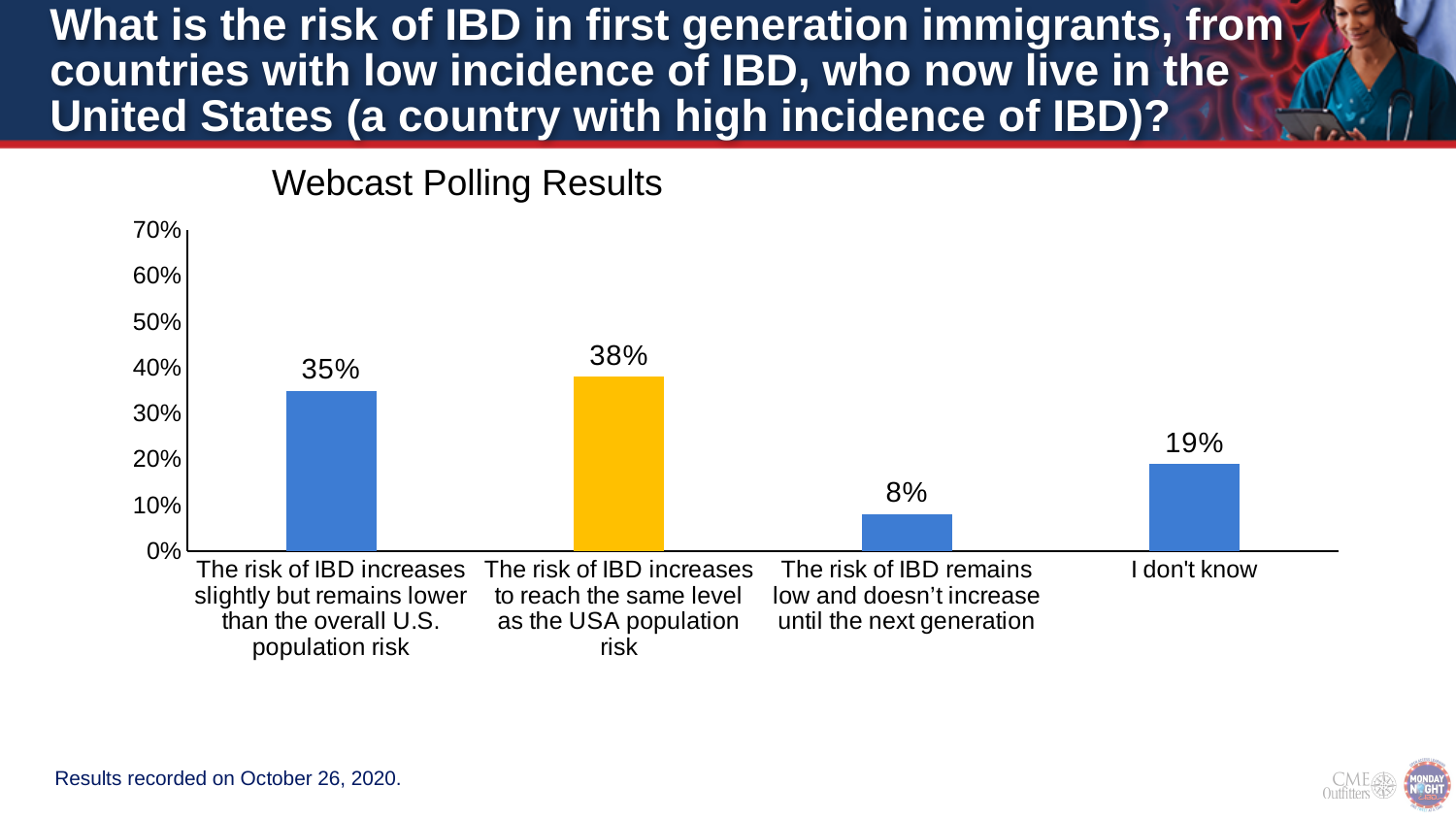
What is the difference between the percentage for "I don't know" and the percentage for "The risk of IBD remains low and doesn't increase until the next generation"? 11 percentage points What percentage of respondents chose "The risk of IBD increases to reach the same level as the USA population risk"? 38% What percentage of respondents chose "I don't know"? 19% What is the title of the chart? Webcast Polling Results How many response options are shown in the chart? 4 What type of chart is used to display the Webcast Polling Results? Bar chart Which received a larger share of votes: "I don't know" or "The risk of IBD increases slightly but remains lower than the overall U.S. population risk"? The risk of IBD increases slightly but remains lower than the overall U.S. population risk Which response option received the highest percentage of votes? The risk of IBD increases to reach the same level as the USA population risk What is the difference in percentage points between the "38%" option and the "35%" option? 3 percentage points Is the value for "I don't know" greater or less than 20%? less What percentage of respondents chose "The risk of IBD remains low and doesn't increase until the next generation"? 8% Which response option received the lowest percentage of votes? The risk of IBD remains low and doesn't increase until the next generation